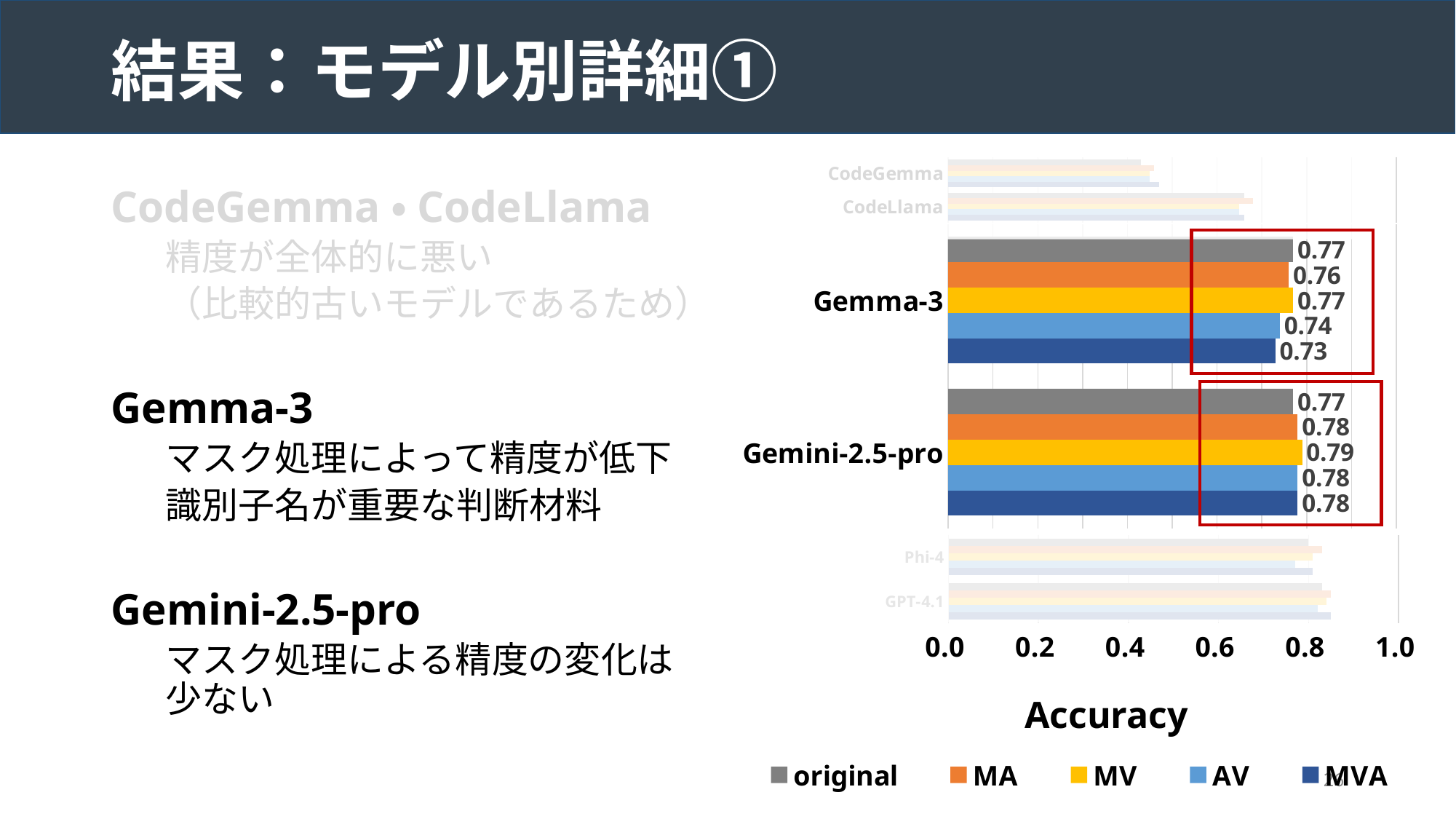
Which series has the highest value for Gemini-2.5-pro? MV What is the difference between the original and MVA values for Gemma-3? 0.04 What is the title of the horizontal axis? Accuracy Which series has the lowest value for Gemma-3? MVA How many series does the legend list? 5 How many model categories are shown on the chart? 6 What is the MV value for Gemini-2.5-pro? 0.79 What is the MVA value for Gemma-3? 0.73 What is the AV value for Gemma-3? 0.74 Is the original value for CodeGemma greater or less than 0.6? less What is the original value for Gemini-2.5-pro? 0.77 Which is larger for Gemma-3, the MA value or the AV value? MA